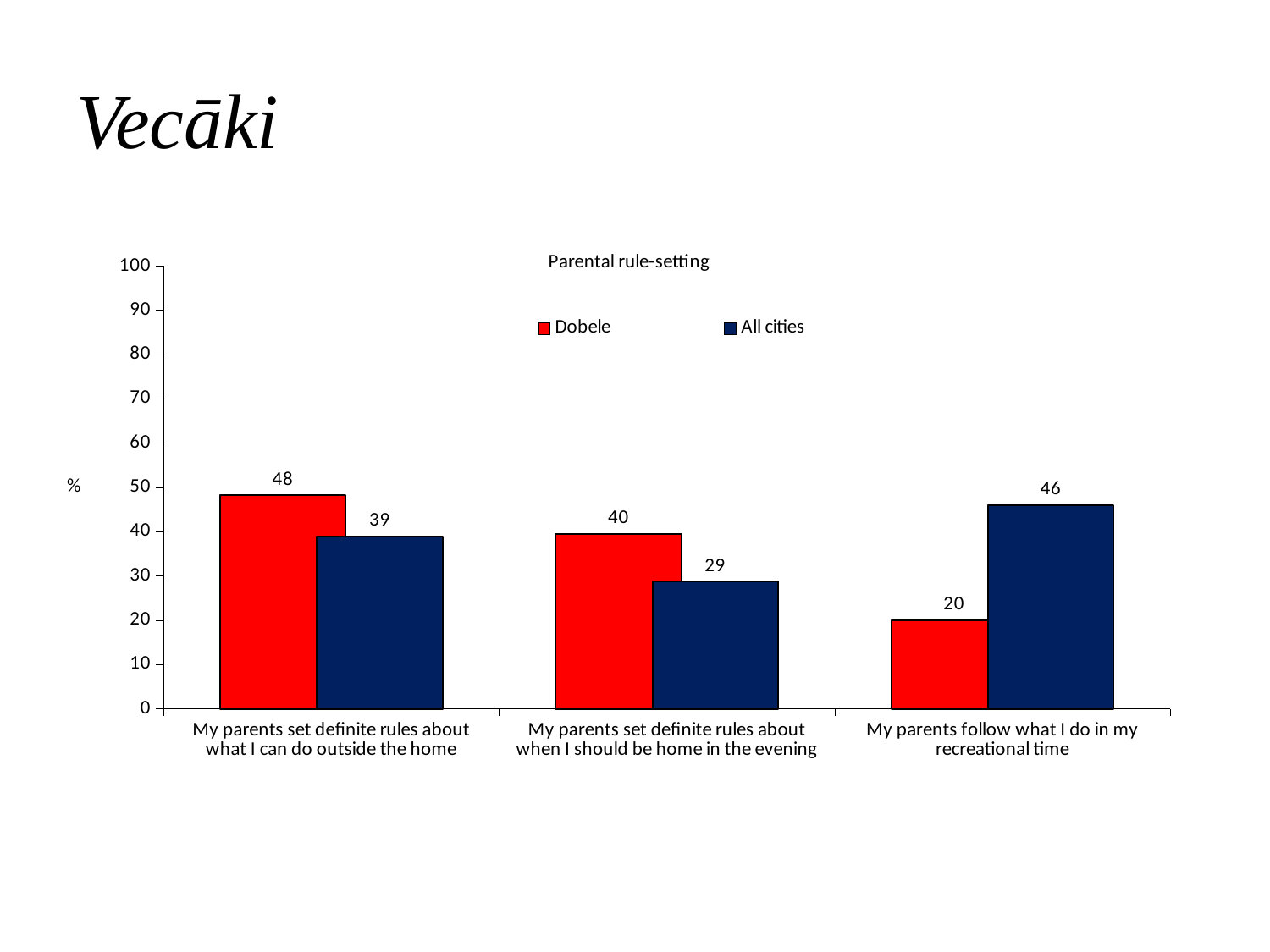
Which category has the lowest Dobele value? My parents follow what I do in my recreational time What is the All cities value for "My parents set definite rules about when I should be home in the evening"? 29 For "My parents follow what I do in my recreational time", which series has the larger value, Dobele or All cities? All cities How many series does the legend list? 2 Is the All cities value for "My parents set definite rules about what I can do outside the home" greater or less than 50? less What is the difference between the Dobele and All cities values for "My parents set definite rules about when I should be home in the evening"? 11 What is the title of the chart? Parental rule-setting What is the Dobele value for "My parents set definite rules about what I can do outside the home"? 48 Which category has the highest All cities value? My parents follow what I do in my recreational time What kind of chart is shown on the slide? bar chart How many categories are shown on the x axis? 3 What is the Dobele value for "My parents follow what I do in my recreational time"? 20